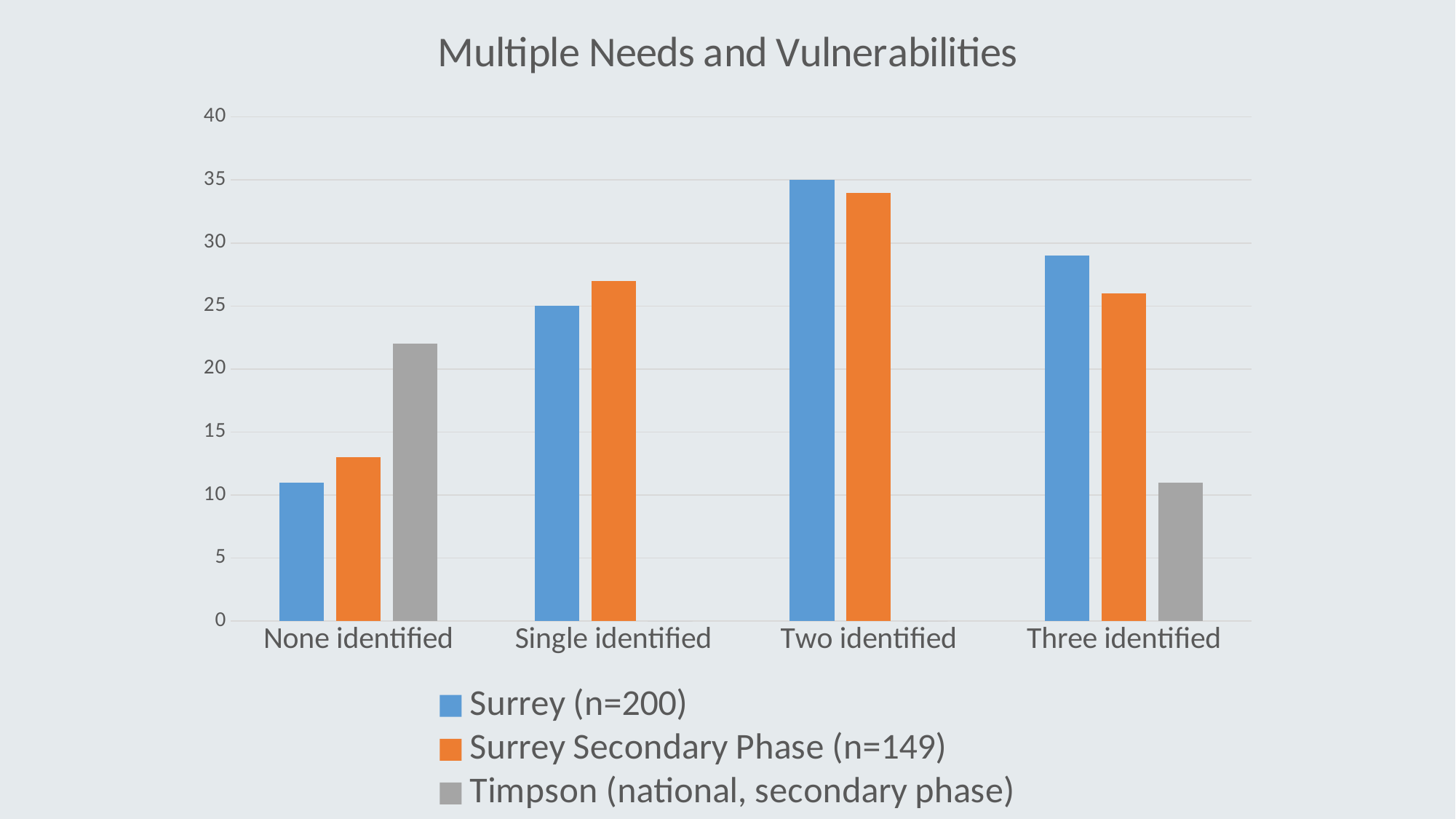
What is the value for Surrey (n=200) in the Two identified category? 35 Which category has the highest value for Surrey (n=200)? Two identified Is the value for Timpson (national, secondary phase) in the None identified category greater or less than 20? greater What is the value for Surrey (n=200) in the Single identified category? 25 How many series does the legend list? 3 What type of chart is shown on the slide? bar chart What is the title of the chart? Multiple Needs and Vulnerabilities In the Single identified category, which is larger: Surrey (n=200) or Surrey Secondary Phase (n=149)? Surrey Secondary Phase (n=149) Which series is shown in grey in the legend? Timpson (national, secondary phase) Which category has the lowest value for Surrey (n=200)? None identified How many categories are shown on the x axis? 4 Is the value for Surrey Secondary Phase (n=149) in the None identified category greater or less than 15? less